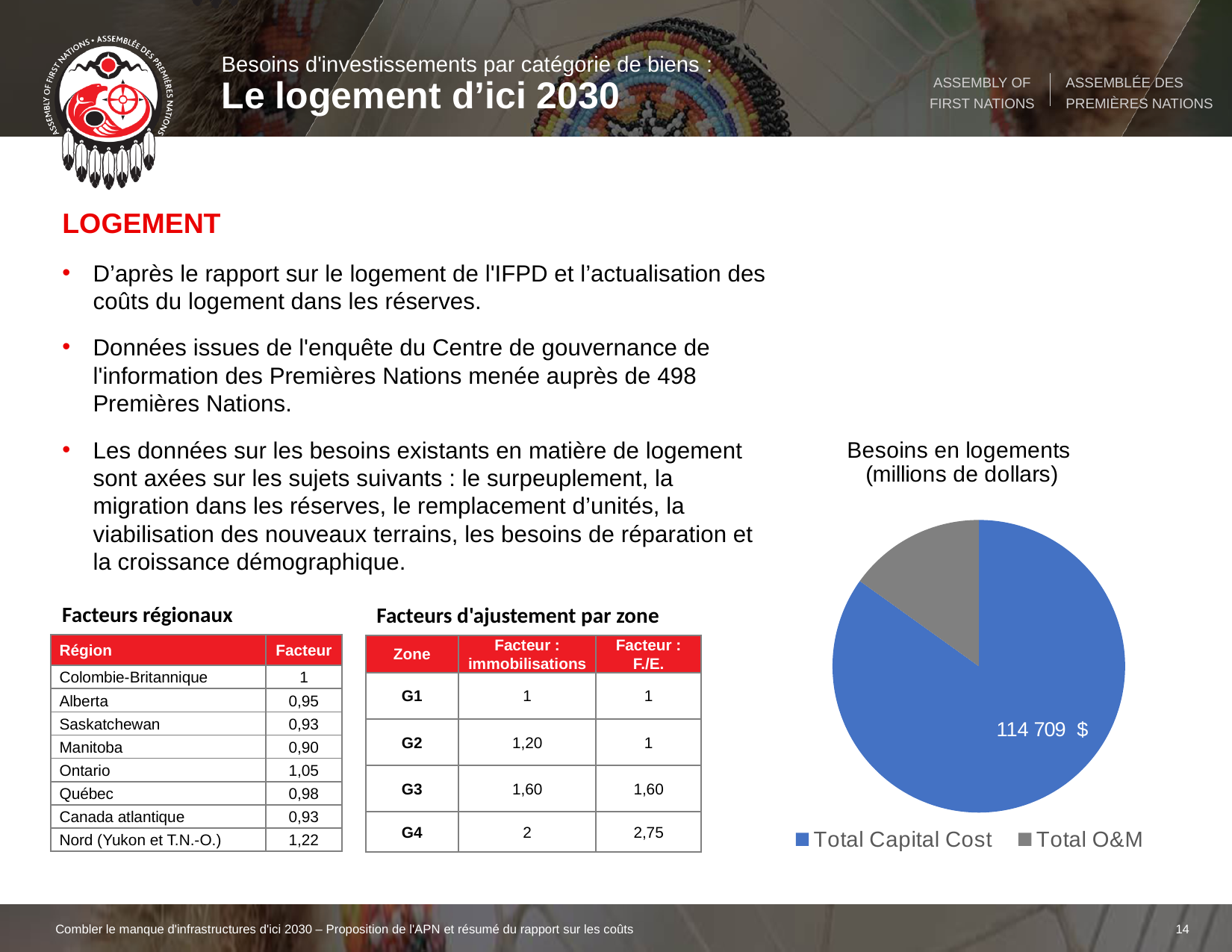
What is the title of the pie chart? Besoins en logements (millions de dollars) What value is printed on the Total Capital Cost slice of the pie chart? 114 709 $ What colour is the Total O&M slice in the pie chart? grey Which is larger in the pie chart, Total Capital Cost or Total O&M? Total Capital Cost How many slices does the pie chart have? 2 Which slice of the pie chart is the smallest? Total O&M What kind of chart is shown on the slide? pie chart How many entries does the legend of the pie chart list? 2 Which slice of the pie chart is the largest? Total Capital Cost